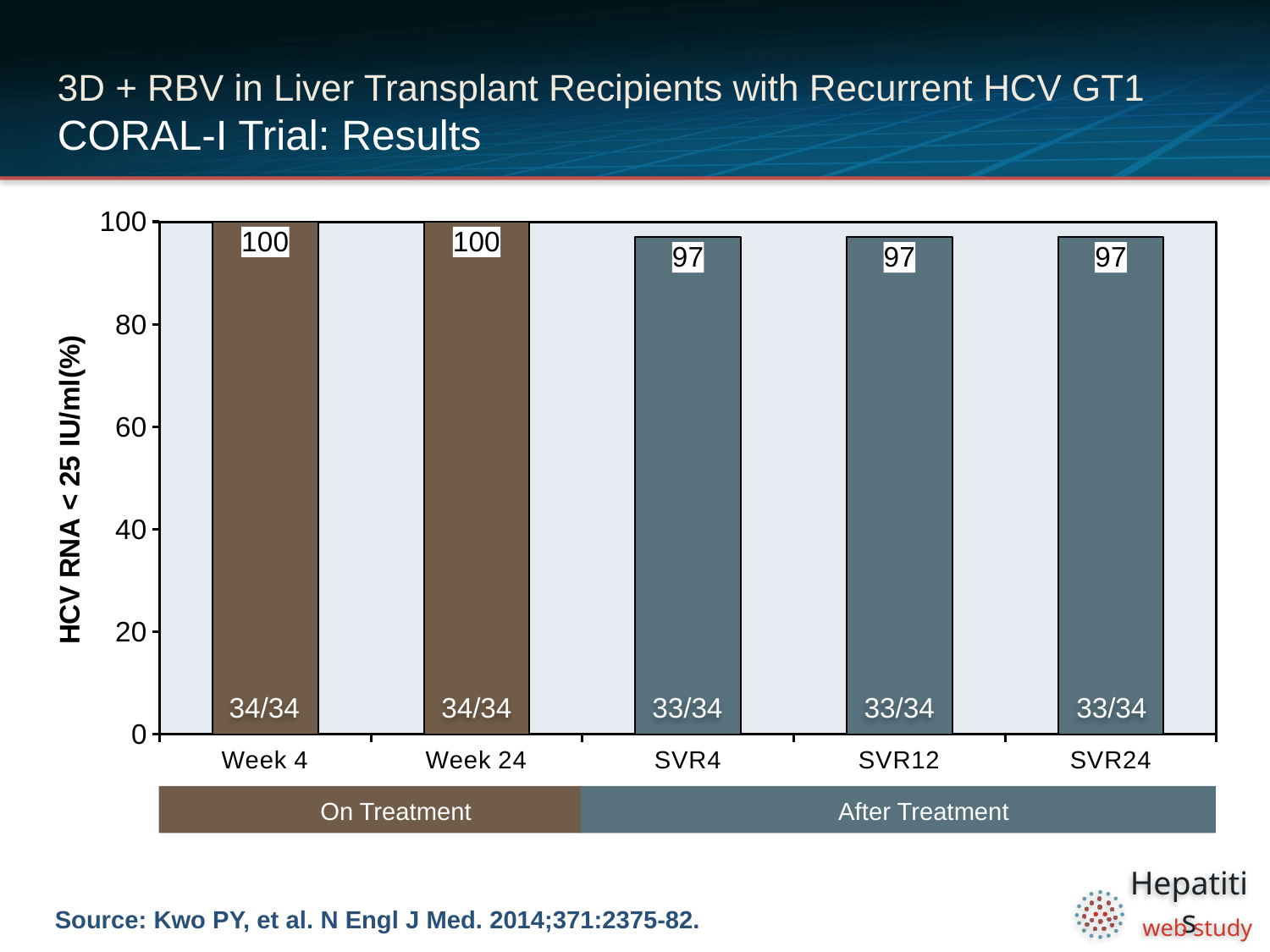
Is the value for SVR4 greater or less than 80? greater What is the difference between the values for Week 24 and SVR12? 3 Which time points are grouped under the 'On Treatment' band below the chart? Week 4 and Week 24 Which is larger, the value for Week 4 or the value for SVR24? Week 4 What is the label of the y axis? HCV RNA < 25 IU/ml(%) What fraction of patients is shown inside the Week 24 bar? 34/34 What is the value for Week 4? 100 How many categories are shown on the x axis? 5 What kind of chart is shown on the slide? bar chart What fraction of patients is shown inside the SVR4 bar? 33/34 What is the value for SVR12? 97 What is the value for SVR24? 97